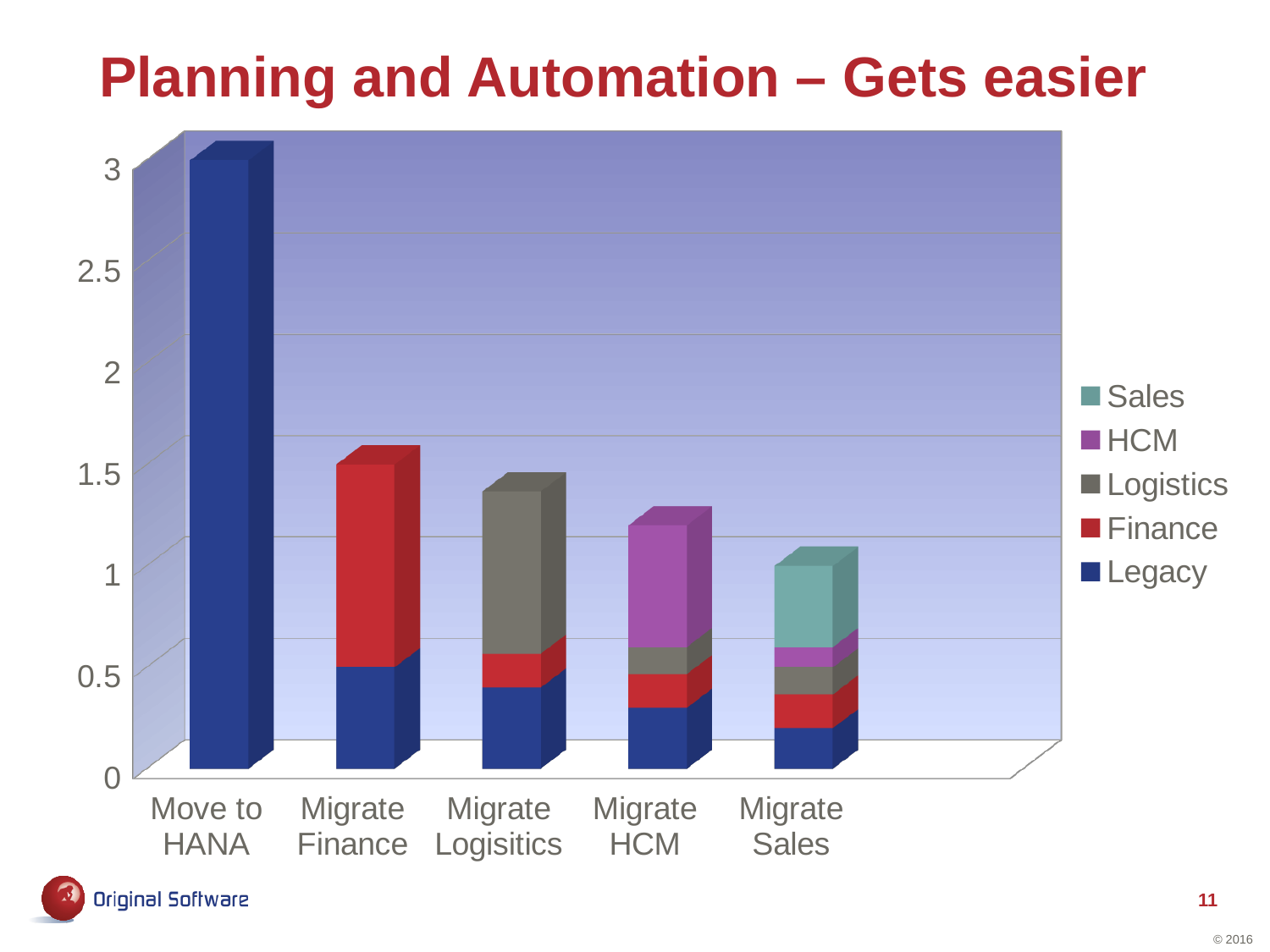
Is the total value for Move to HANA greater or less than 2.5? greater Is the total value for Migrate Sales greater or less than 1.5? less Is the total value for Migrate Logisitics greater or less than 1? greater Which series is shown at the bottom of every stacked bar? Legacy Do the total bar heights rise or fall moving from left to right along the x axis? Fall What is the title of the slide containing the chart? Planning and Automation – Gets easier How many categories are shown along the x axis of the chart? 5 What kind of chart is shown on the slide? Stacked bar chart Which category has the tallest bar in the chart? Move to HANA How many series does the chart's legend list? 5 Which bar is taller, Migrate Finance or Migrate HCM? Migrate Finance